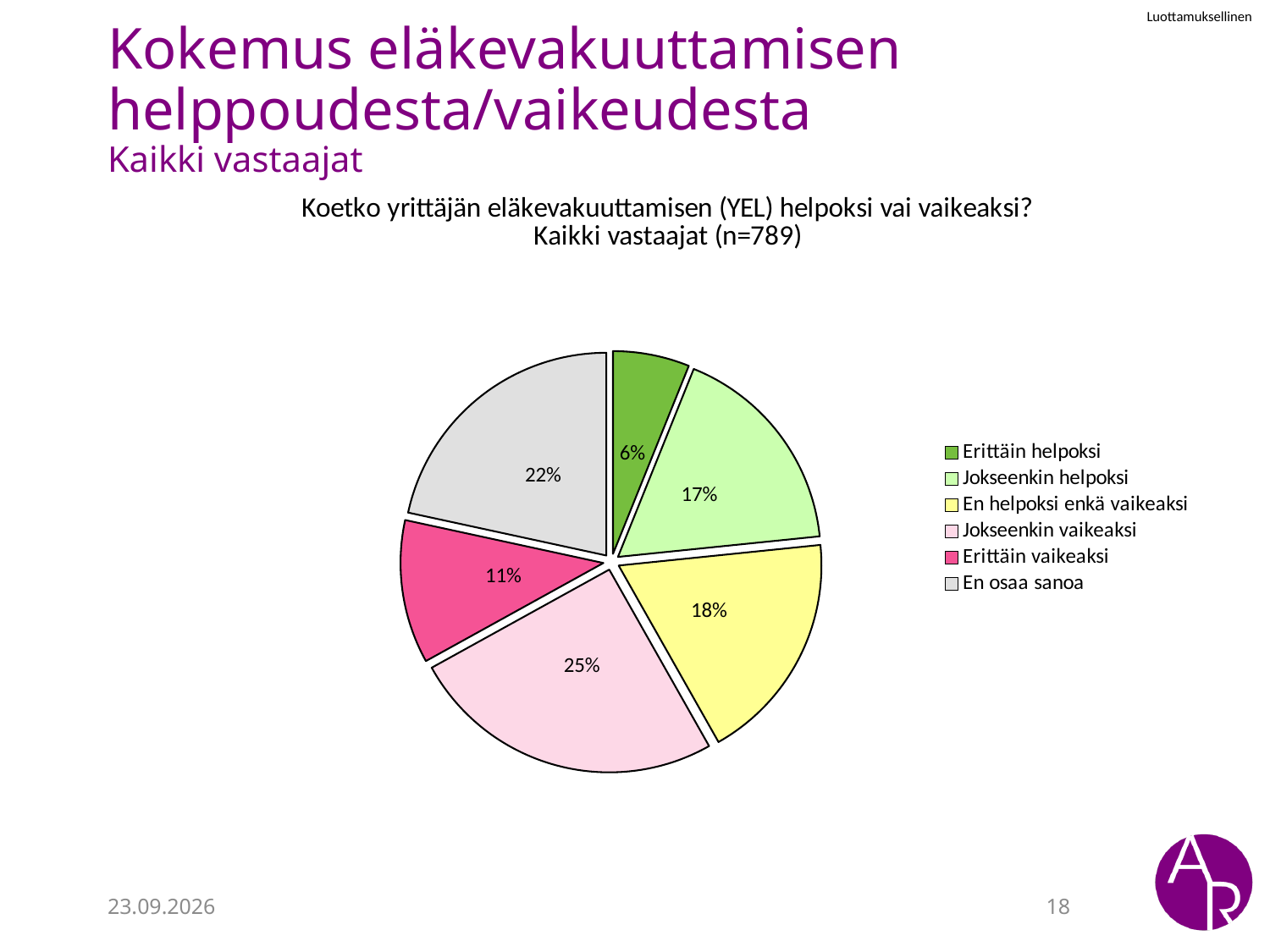
How many categories does the pie chart have? 6 What colour is the slice for "Erittäin vaikeaksi"? pink What percentage of respondents answered "Jokseenkin vaikeaksi"? 25% How many respondents (n) does the chart subtitle state? 789 What is the difference in percentage points between "Jokseenkin vaikeaksi" and "Erittäin vaikeaksi"? 14 What percentage of respondents answered "En osaa sanoa"? 22% What percentage of respondents answered "En helpoksi enkä vaikeaksi"? 18% What percentage of respondents answered "Erittäin helpoksi"? 6% Which is larger, the share for "Jokseenkin helpoksi" or the share for "En osaa sanoa"? En osaa sanoa Which category has the largest share of the pie? Jokseenkin vaikeaksi Which category has the smallest share of the pie? Erittäin helpoksi What type of chart is shown on the slide? pie chart